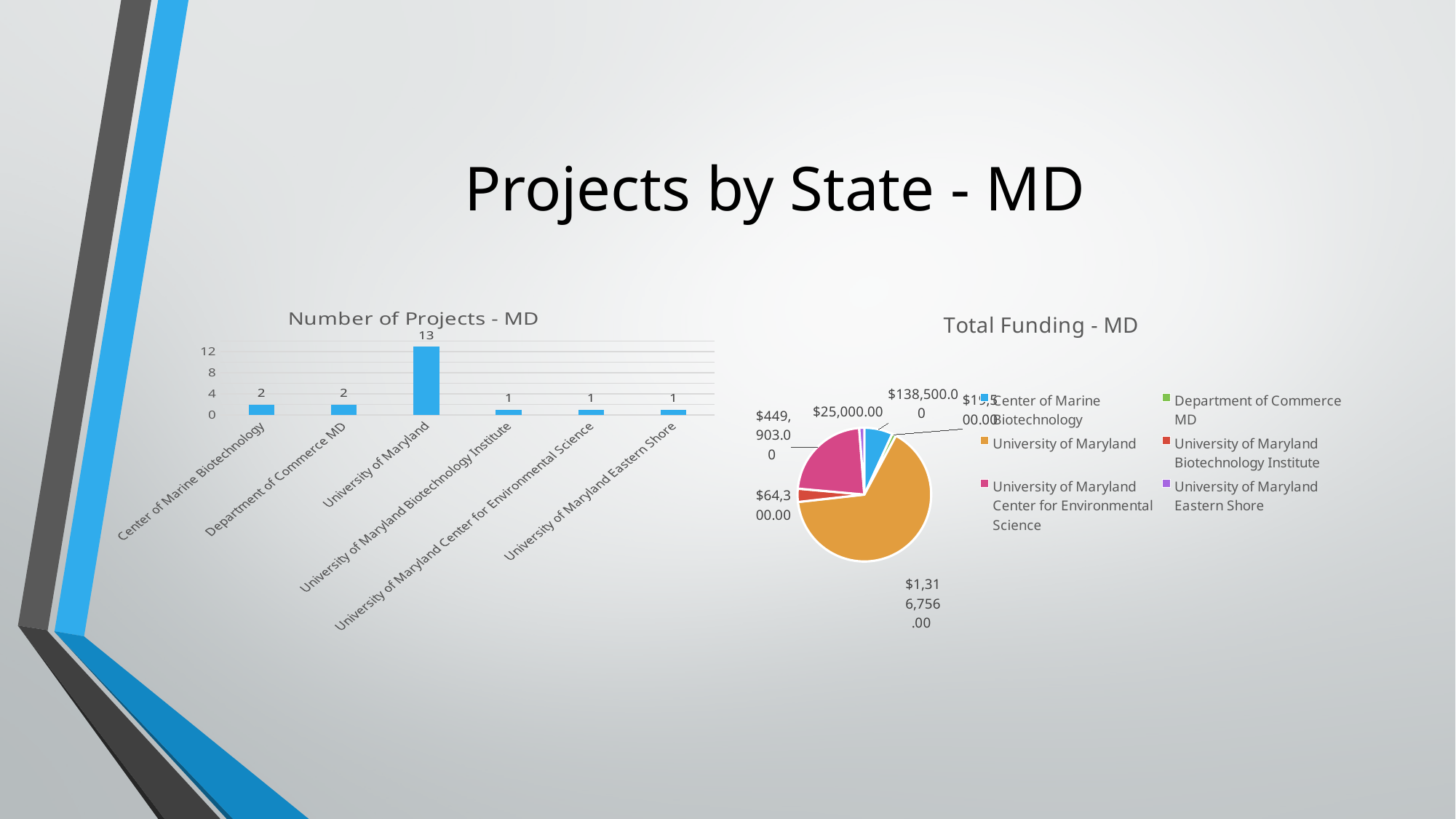
In the 'Number of Projects - MD' chart, which category has the highest number of projects? University of Maryland In the 'Number of Projects - MD' chart, how many projects does University of Maryland have? 13 In the 'Total Funding - MD' chart, what is the difference between the funding for University of Maryland Center for Environmental Science and Center of Marine Biotechnology? $311,403.00 In the 'Number of Projects - MD' chart, how many projects does Department of Commerce MD have? 2 In the 'Total Funding - MD' chart, what is the funding value for University of Maryland Center for Environmental Science? $449,903.00 In the 'Total Funding - MD' chart, which organization has the largest slice? University of Maryland What kind of chart is 'Number of Projects - MD'? Bar chart In the 'Number of Projects - MD' chart, how many categories are shown on the x axis? 6 In the 'Number of Projects - MD' chart, what is the difference between the number of projects for University of Maryland and Center of Marine Biotechnology? 11 How many entries does the legend of the 'Total Funding - MD' chart list? 6 In the 'Total Funding - MD' chart, what is the total funding for University of Maryland? $1,316,756.00 In the 'Number of Projects - MD' chart, which has more projects: Department of Commerce MD or University of Maryland Eastern Shore? Department of Commerce MD